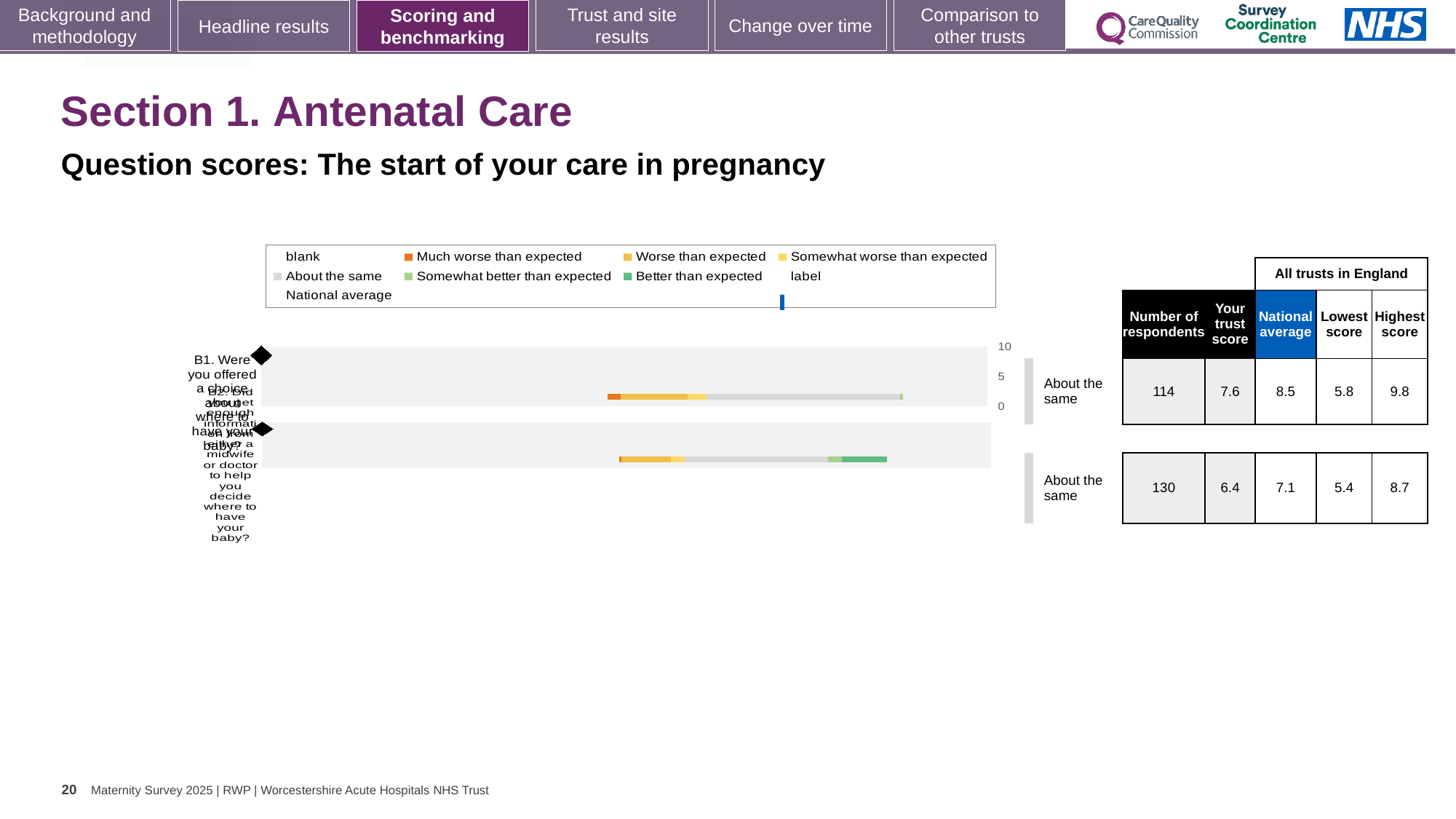
Which question has the higher trust score, B1 or B2? B1 What benchmark category is shown for B1 next to the chart? About the same What is the lowest score among all trusts in England for B1? 5.8 What is the trust score for B1 (Were you offered a choice about where to have your baby?)? 7.6 What is the national average for B1 (Were you offered a choice about where to have your baby?)? 8.5 What kind of chart is used to show the question scores for B1 and B2? bar chart Which question has the higher number of respondents, B1 or B2? B2 What is the difference between the national average and the trust score for B2? 0.7 How many respondents answered B2 (Did you get enough information from either a midwife or doctor to help you decide where to have your baby?)? 130 What is the highest score among all trusts in England for B2? 8.7 How many questions (categories) are plotted in the chart? 2 Which legend entry is shown in orange? Much worse than expected